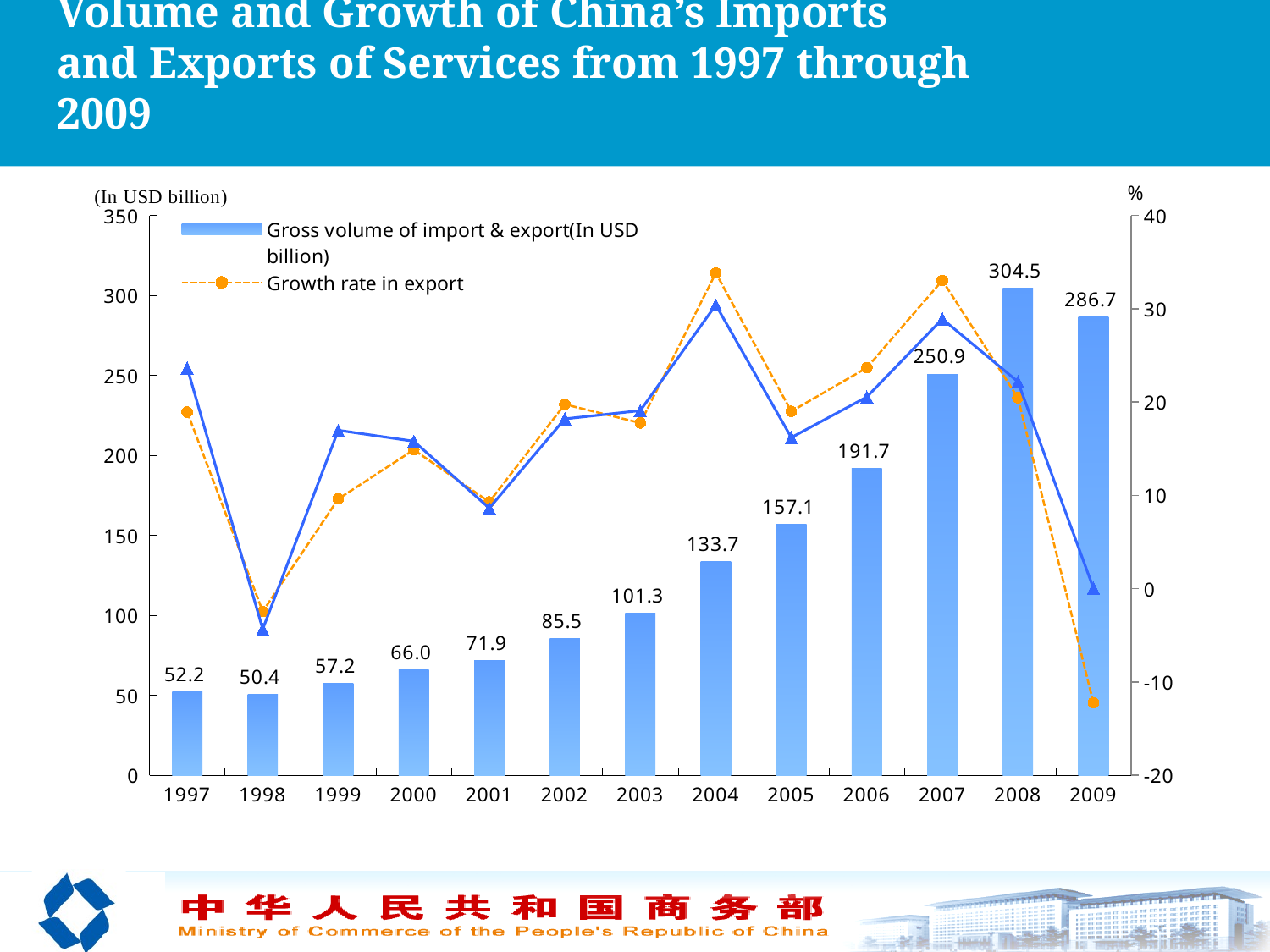
What is the difference in gross volume of import & export between 2007 and 2006? 59.2 Which year has the lowest gross volume of import & export? 1998 Is the growth rate in export for 2004 greater or less than 30? greater What is the difference in gross volume of import & export between 2008 and 2009? 17.8 Is the growth rate in export for 2009 greater or less than -10? less What is the gross volume of import & export for 2001? 71.9 Which year has the highest gross volume of import & export? 2008 What is the gross volume of import & export for 2008? 304.5 How many series does the chart legend list? 2 Does the gross volume of import & export generally rise or fall from 1998 to 2008? rise Which year has a larger gross volume of import & export, 2005 or 2006? 2006 How many years are shown on the x axis of the chart? 13